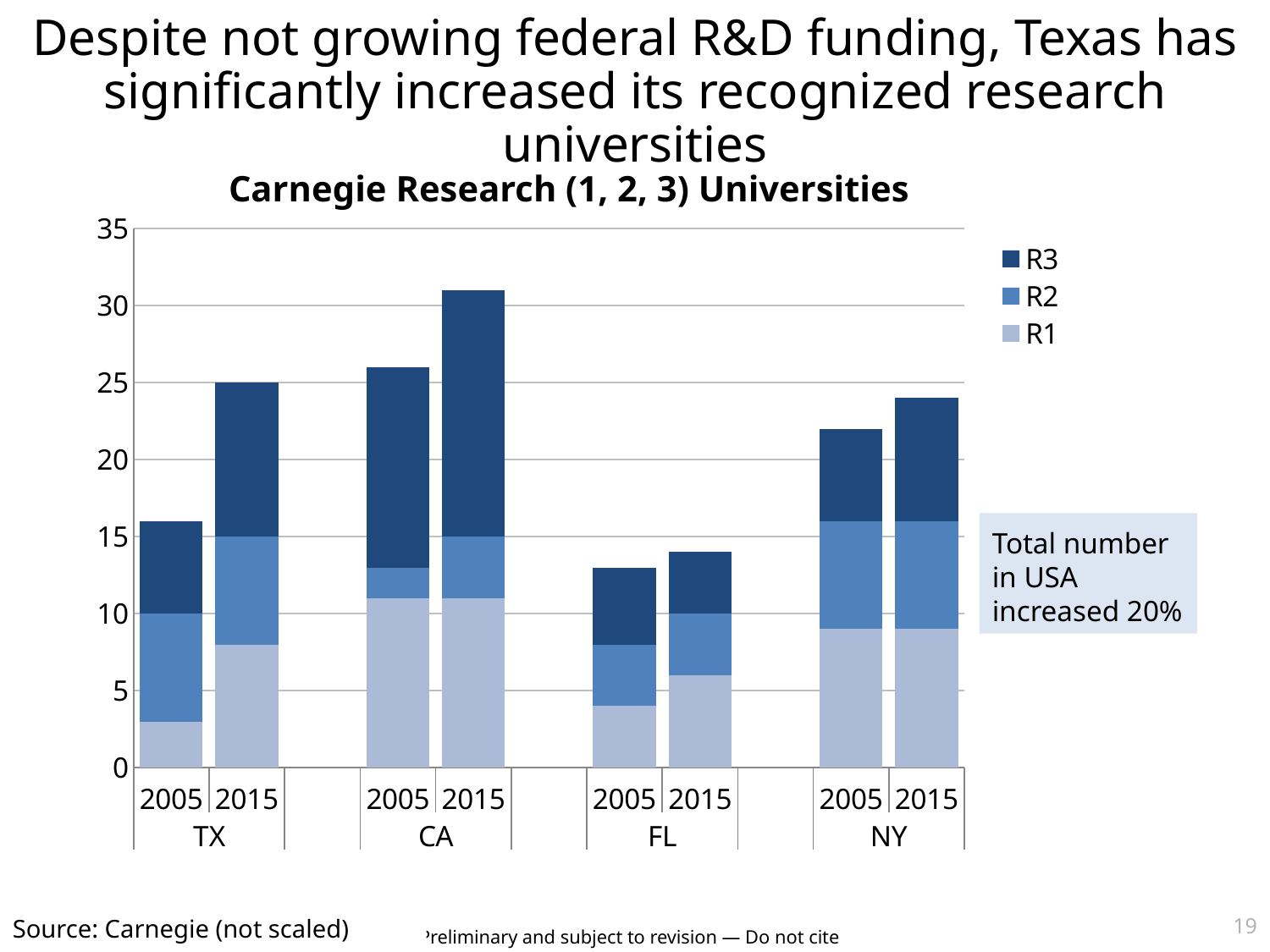
Which bar has the lowest total in the chart? FL 2005 How many series does the legend list? 3 Is the total for FL 2005 greater or less than 15? less Which bar has the highest total in the chart? CA 2015 Which is larger, the total for TX 2015 or the total for FL 2015? TX 2015 Does the total for TX rise or fall from 2005 to 2015? rise What is the total height of the TX 2015 bar? 25 What is the title of the chart? Carnegie Research (1, 2, 3) Universities What kind of chart is shown on the slide? stacked bar chart How many bars are plotted in the chart? 8 How many states are shown on the x axis of the chart? 4 Is the total for CA 2015 greater or less than 30? greater